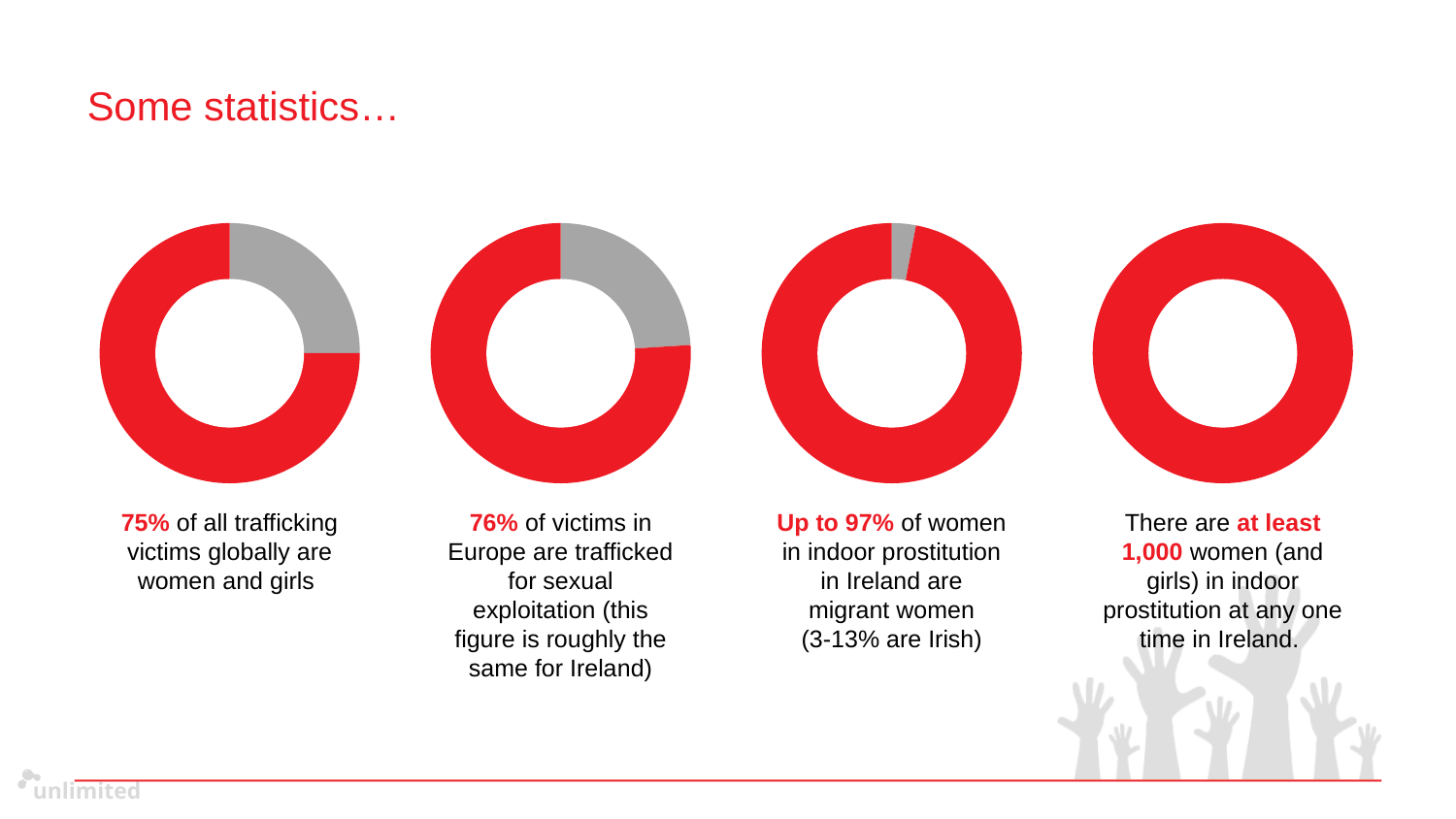
Does the rightmost chart show any grey segment? No What colour is used for the larger segment in each donut chart? red In the second chart from the left, what share of the donut is the grey segment? 24% In the second chart from the left, what percentage of victims in Europe are trafficked for sexual exploitation? 76% How many donut charts are shown on the slide? 4 In the third chart from the left, what percentage of women in indoor prostitution in Ireland are migrant women? 97% In the leftmost chart, what share of the donut is the grey segment? 25% In the leftmost chart, what percentage does the red segment represent (trafficking victims globally who are women and girls)? 75% Which has the larger red share: the leftmost chart or the third chart from the left? the third chart What kind of chart is the leftmost chart on the slide? donut chart What is the title of the slide containing the donut charts? Some statistics… Is the red share in the third chart from the left greater or less than 90%? greater